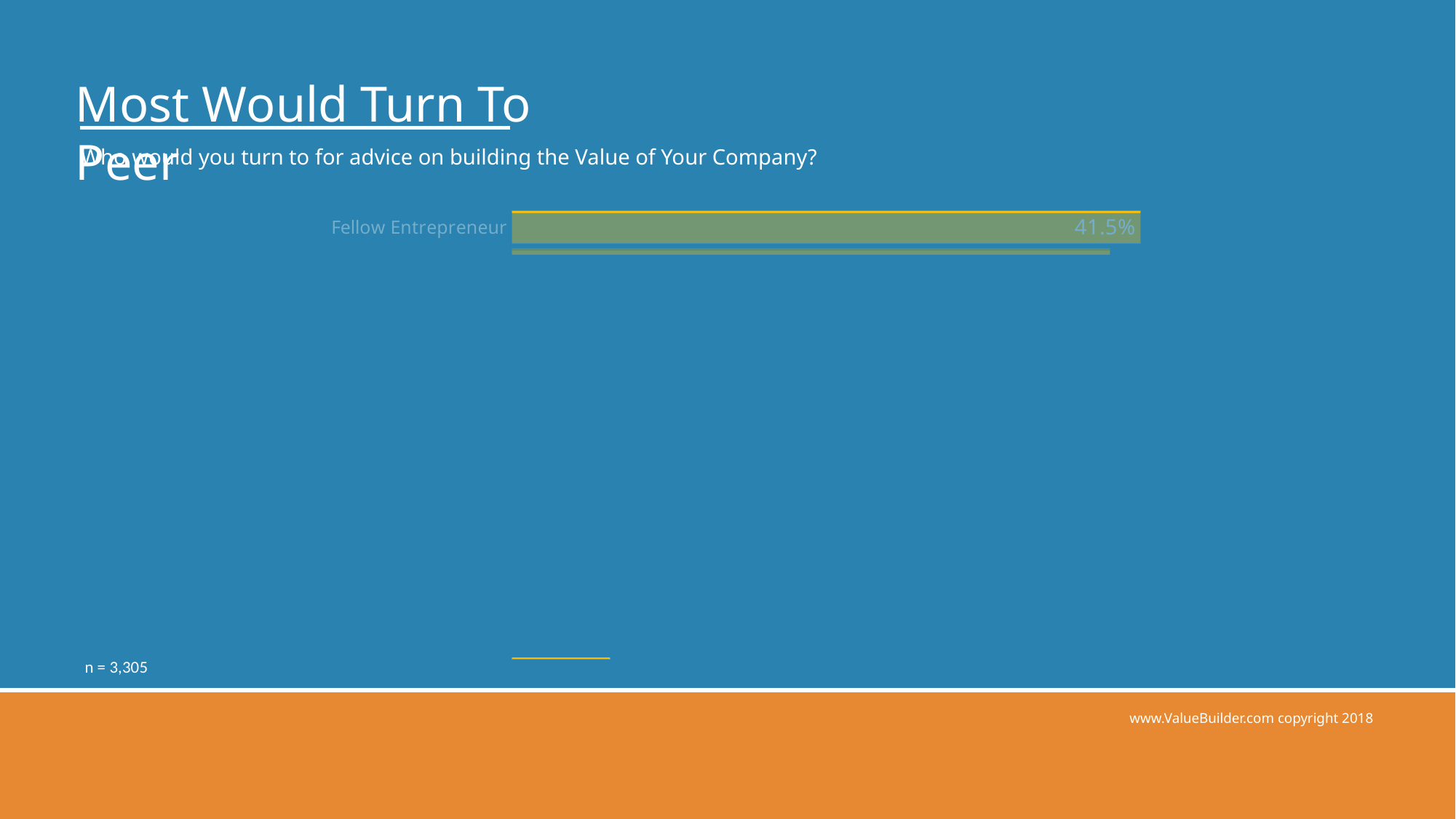
What survey question does the chart answer, as stated above the chart? Who would you turn to for advice on building the Value of Your Company? What value is shown for Fellow Entrepreneur? 41.5% Is the value for Fellow Entrepreneur greater or less than 40%? greater Which category label is shown on the chart? Fellow Entrepreneur What kind of chart is shown on the slide? bar chart Is the value for Fellow Entrepreneur greater or less than 50%? less